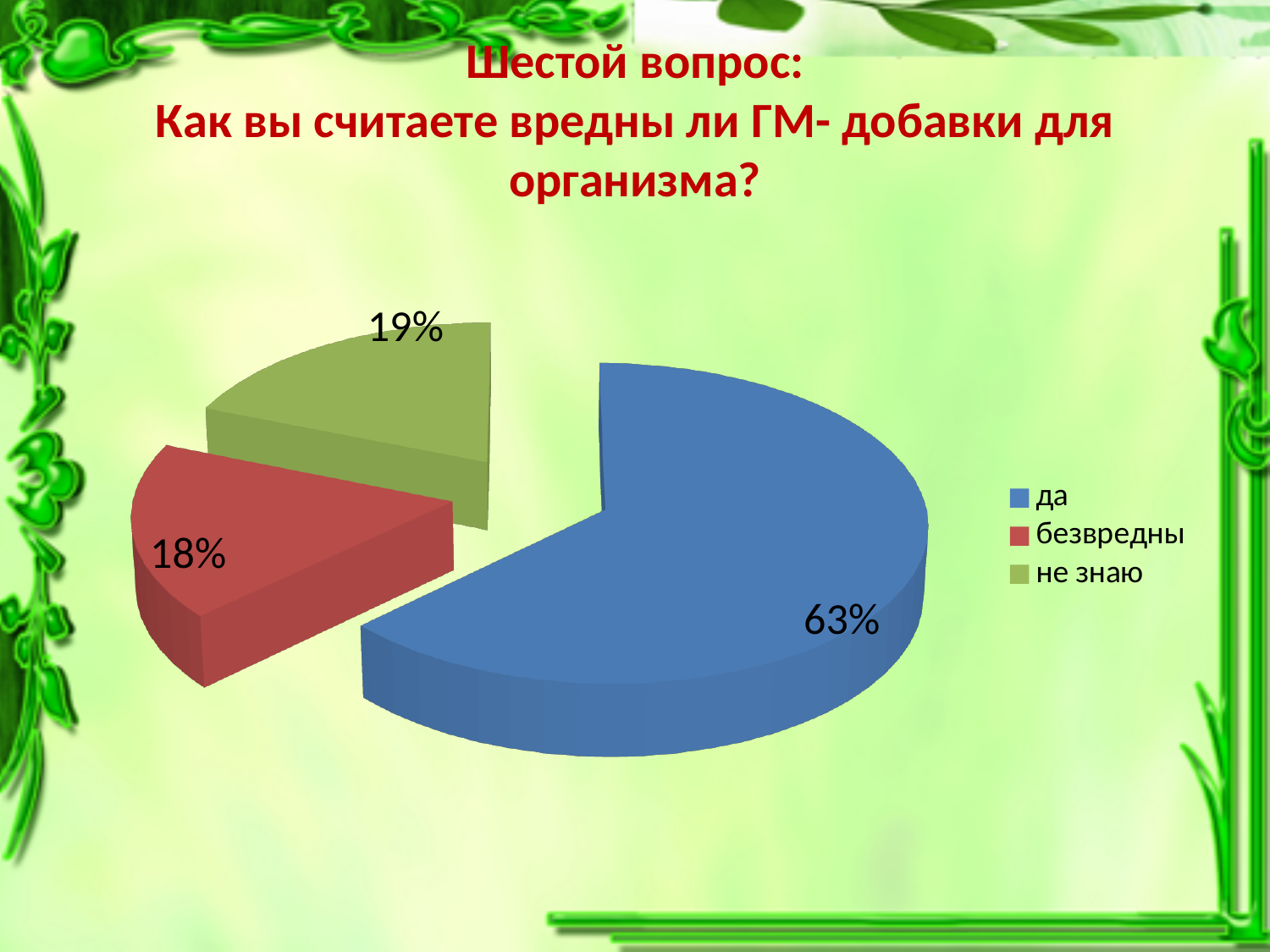
What kind of chart is shown on the slide? pie chart What share of the pie does the "да" slice represent? 63% What share of the pie does the "не знаю" slice represent? 19% How many entries does the legend list? 3 Which category has the largest share of the pie? да What is the difference in percentage points between the "не знаю" slice and the "безвредны" slice? 1 What share of the pie does the "безвредны" slice represent? 18% Which category has the smallest share of the pie? безвредны How many slices does the pie chart have? 3 Which is larger, the share for "да" or the share for "безвредны"? да What colour is the "не знаю" slice in the pie chart? green What is the difference in percentage points between the "да" slice and the "не знаю" slice? 44